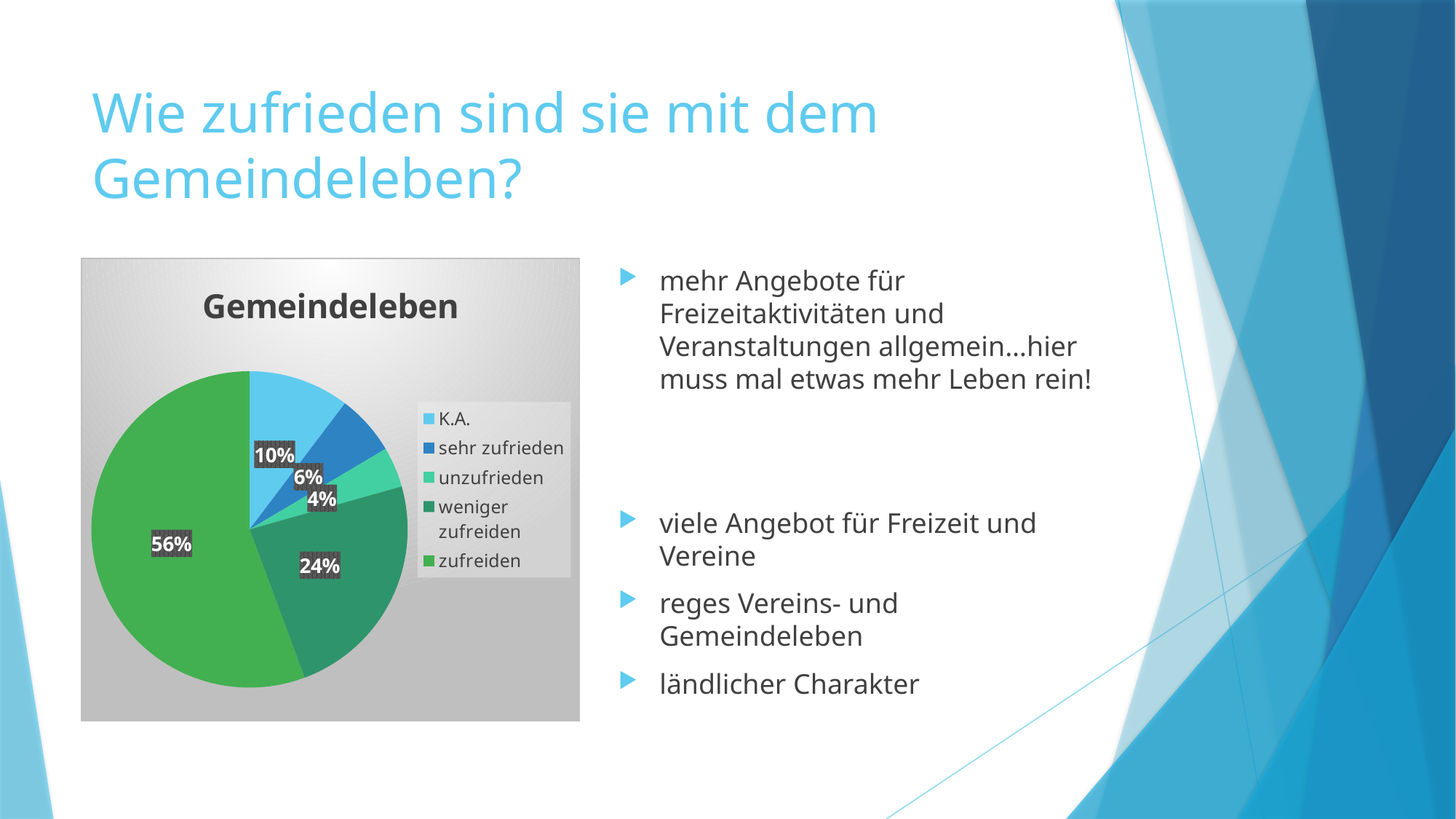
Which is larger, the slice for "K.A." or the slice for "sehr zufrieden"? K.A. What is the difference in percentage points between "zufreiden" and "weniger zufreiden"? 32 What is the title of the chart? Gemeindeleben How many categories does the legend list? 5 Which category has the largest slice of the pie? zufreiden What kind of chart is shown on the slide? Pie chart What share of the pie is labelled "weniger zufreiden"? 24% What share of the pie is labelled "zufreiden"? 56% What share of the pie is labelled "K.A."? 10% What share of the pie is labelled "sehr zufrieden"? 6% Which category has the smallest slice of the pie? unzufrieden What share of the pie is labelled "unzufrieden"? 4%